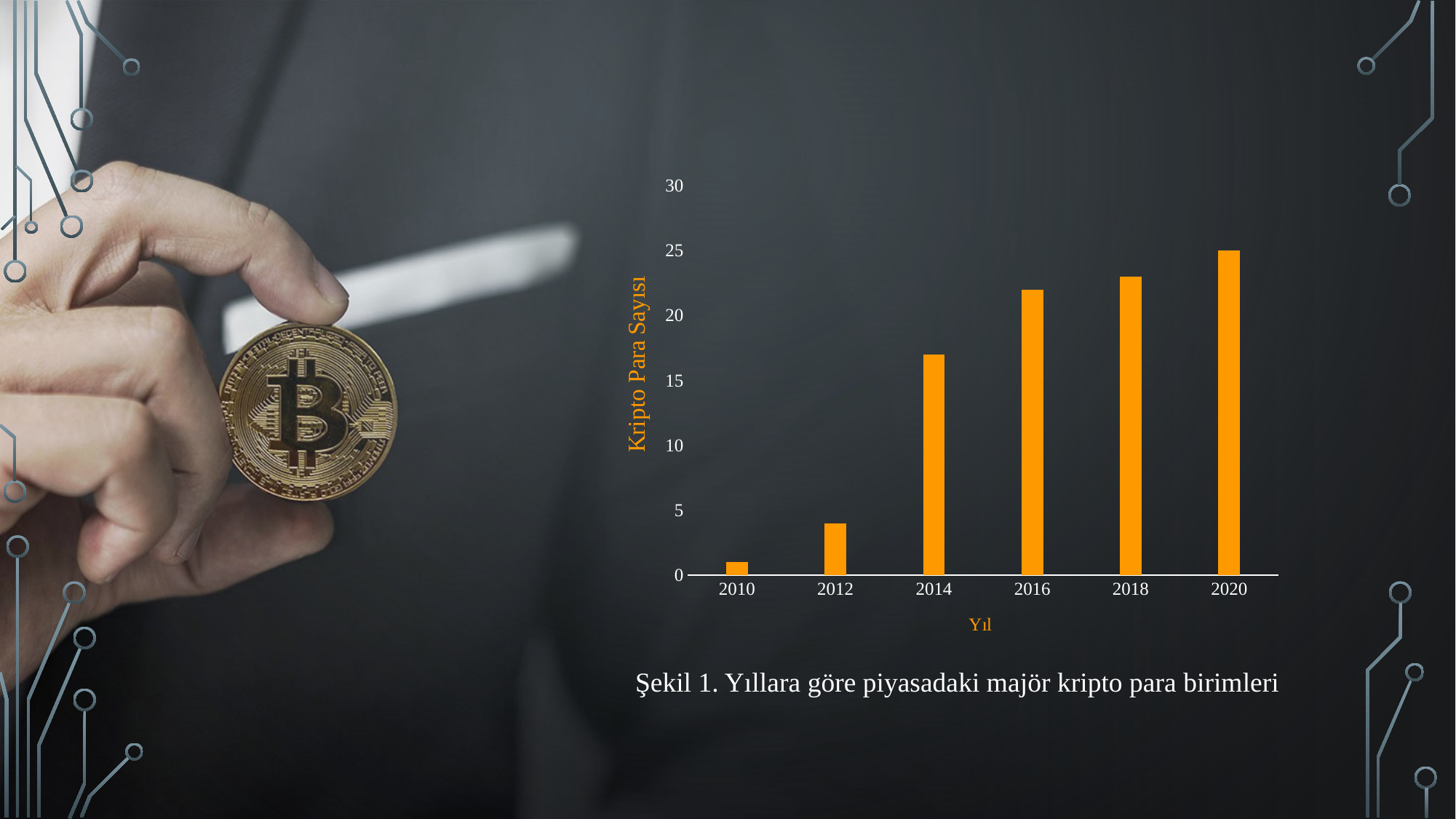
Which year has the highest value in the chart? 2020 Do the values rise or fall from 2010 to 2020? rise What is the title of the vertical axis of the chart? Kripto Para Sayısı Is the value for 2016 greater or less than 20? greater Is the value for 2010 greater or less than 5? less Is the value for 2012 greater or less than 5? less Which year has the lowest value in the chart? 2010 What is the title of the horizontal axis of the chart? Yıl How many years are shown on the x axis of the chart? 6 What kind of chart is shown on the slide? bar chart Which year has the larger value, 2014 or 2016? 2016